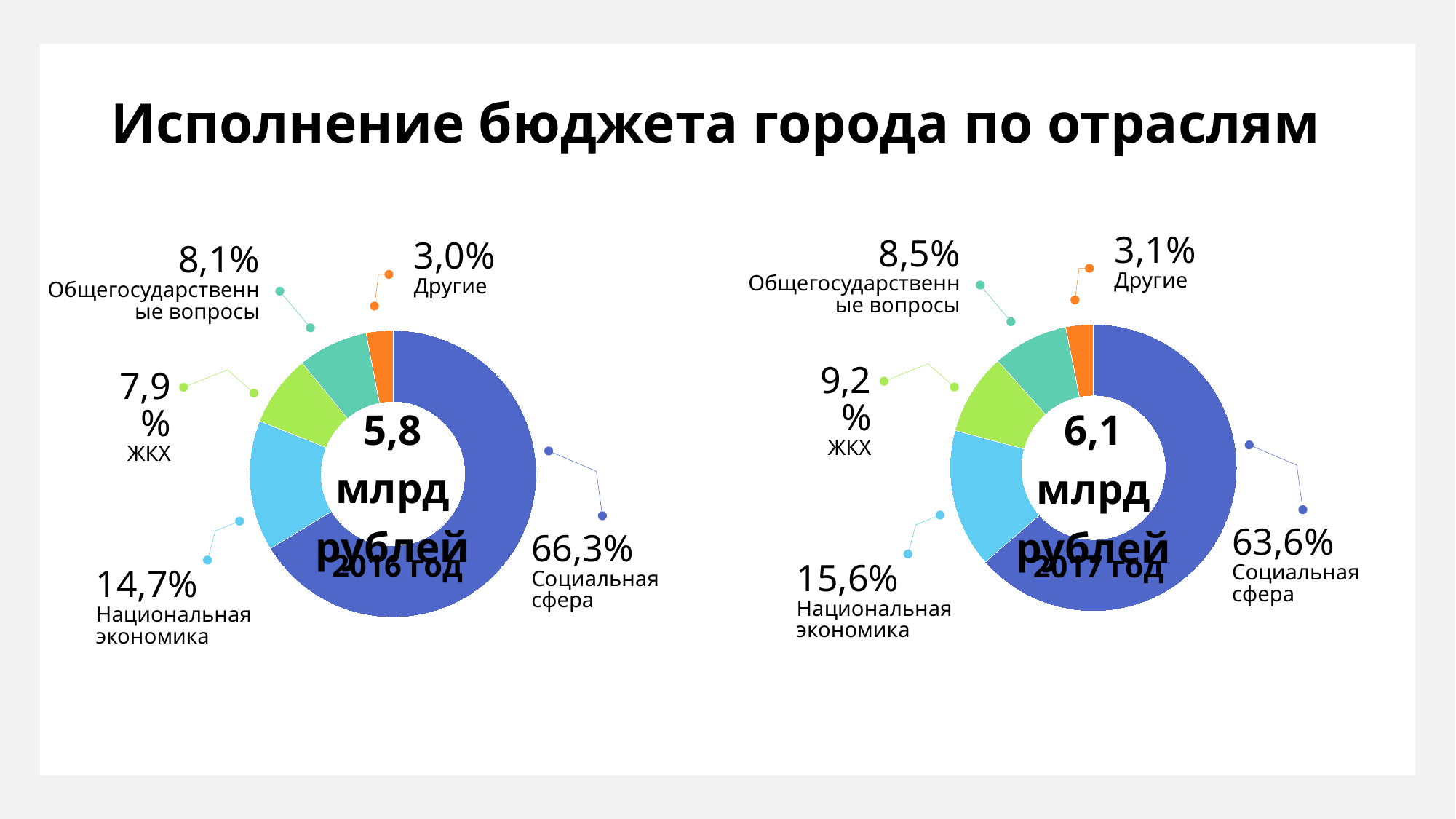
How many categories does the 2016 год chart show? 5 In the 2016 год chart, which is larger: Общегосударственные вопросы or ЖКХ? Общегосударственные вопросы In the 2017 год chart, which category has the smallest share? Другие In the 2016 год chart, which category has the largest share? Социальная сфера In the 2016 год chart, what share does Социальная сфера have? 66,3% In the 2017 год chart, what share does Национальная экономика have? 15,6% What kind of chart is the 2017 год chart? Donut (pie) chart In the 2017 год chart, what is the value for Общегосударственные вопросы? 8,5% What is the title of the slide? Исполнение бюджета города по отраслям In the 2017 год chart, what is the difference between the shares of Национальная экономика and ЖКХ? 6,4% In the 2016 год chart, what is the value for ЖКХ? 7,9% What total amount is shown in the centre of the 2017 год chart? 6,1 млрд рублей